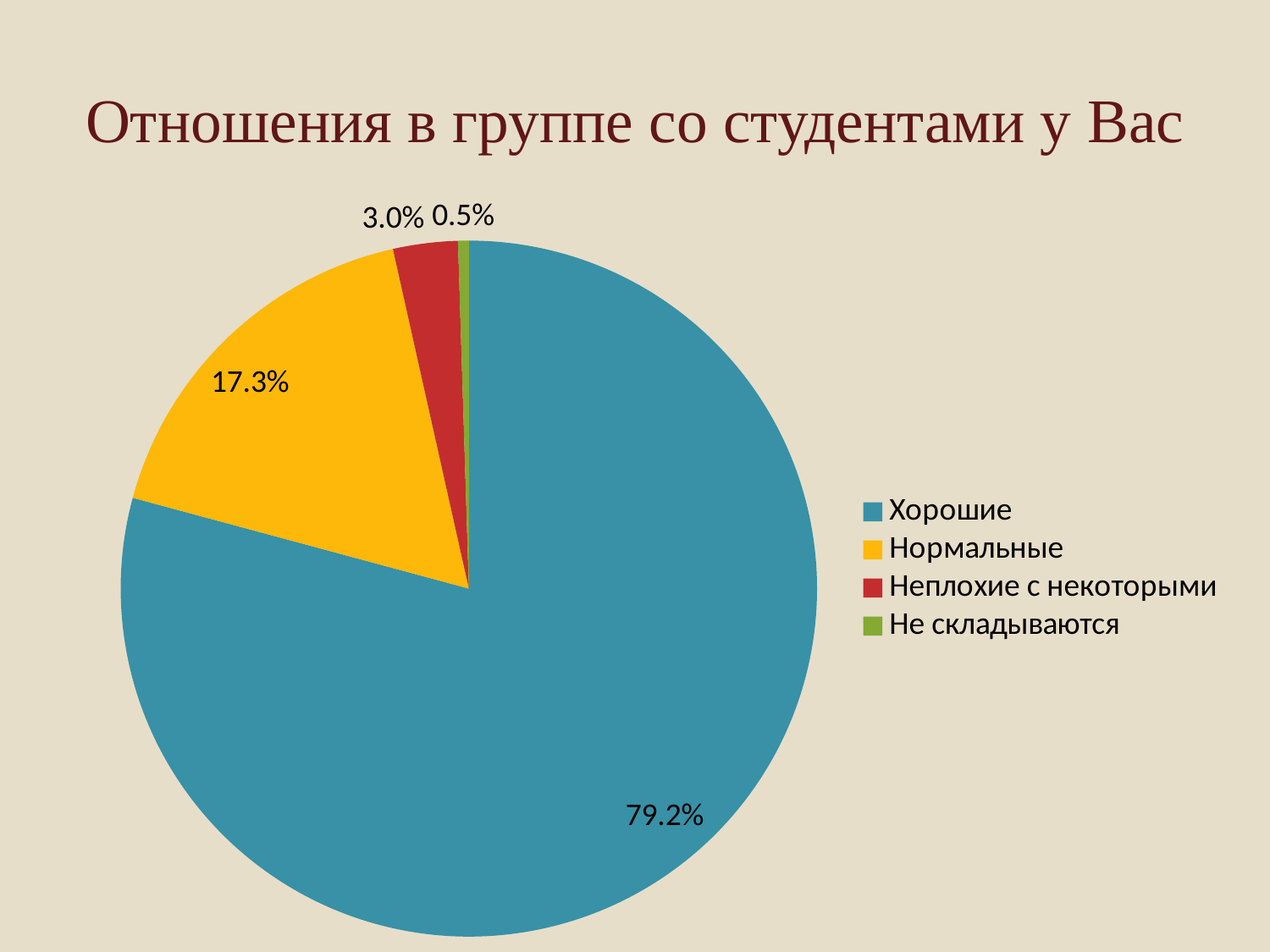
Which is larger, the share for 'Нормальные' or the share for 'Неплохие с некоторыми'? Нормальные What share of the pie does the 'Хорошие' slice have? 79.2% What kind of chart is shown on the slide? pie chart Which category has the largest slice of the pie? Хорошие What is the title of the chart on the slide? Отношения в группе со студентами у Вас What is the difference between the shares of 'Хорошие' and 'Нормальные'? 61.9% How many categories does the pie chart have? 4 Which category has the smallest slice of the pie? Не складываются What colour is the 'Нормальные' slice? yellow What share of the pie does the 'Нормальные' slice have? 17.3% What share of the pie does the 'Не складываются' slice have? 0.5%